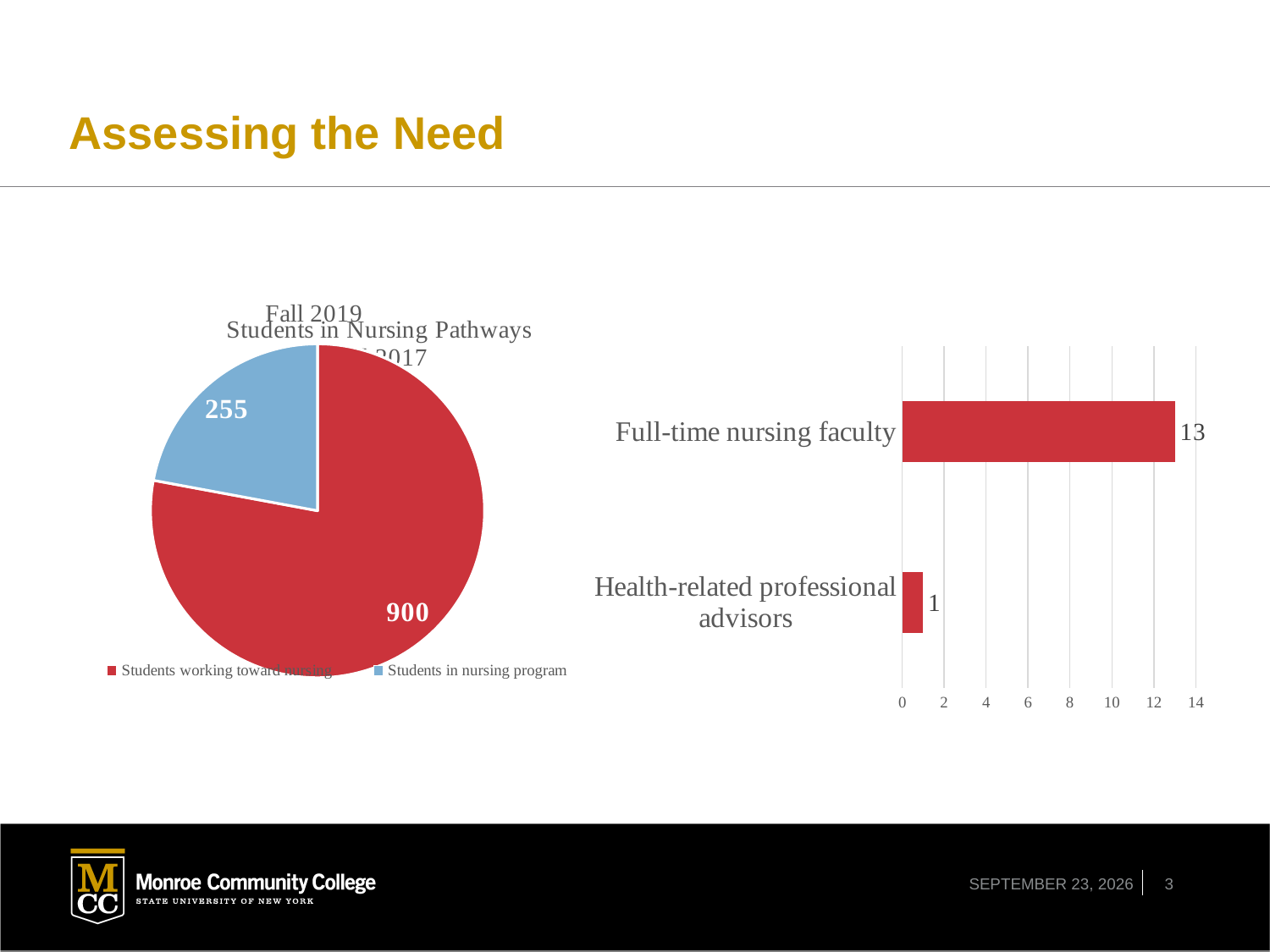
In the pie chart on the left, how many students are working toward nursing? 900 In the pie chart on the left, which slice is larger: Students working toward nursing or Students in nursing program? Students working toward nursing What kind of chart is shown on the left of the slide? Pie chart In the pie chart on the left, which colour represents Students in nursing program? Blue In the bar chart on the right, what is the difference between Full-time nursing faculty and Health-related professional advisors? 12 What kind of chart is shown on the right of the slide? Bar chart In the bar chart on the right, what is the value for Health-related professional advisors? 1 In the bar chart on the right, what is the value for Full-time nursing faculty? 13 In the pie chart on the left, what is the total number of students across both slices? 1155 In the pie chart on the left, how many students are in the nursing program? 255 In the pie chart on the left, how many slices are there? 2 In the pie chart on the left, what is the difference between the number of students working toward nursing and the number in the nursing program? 645